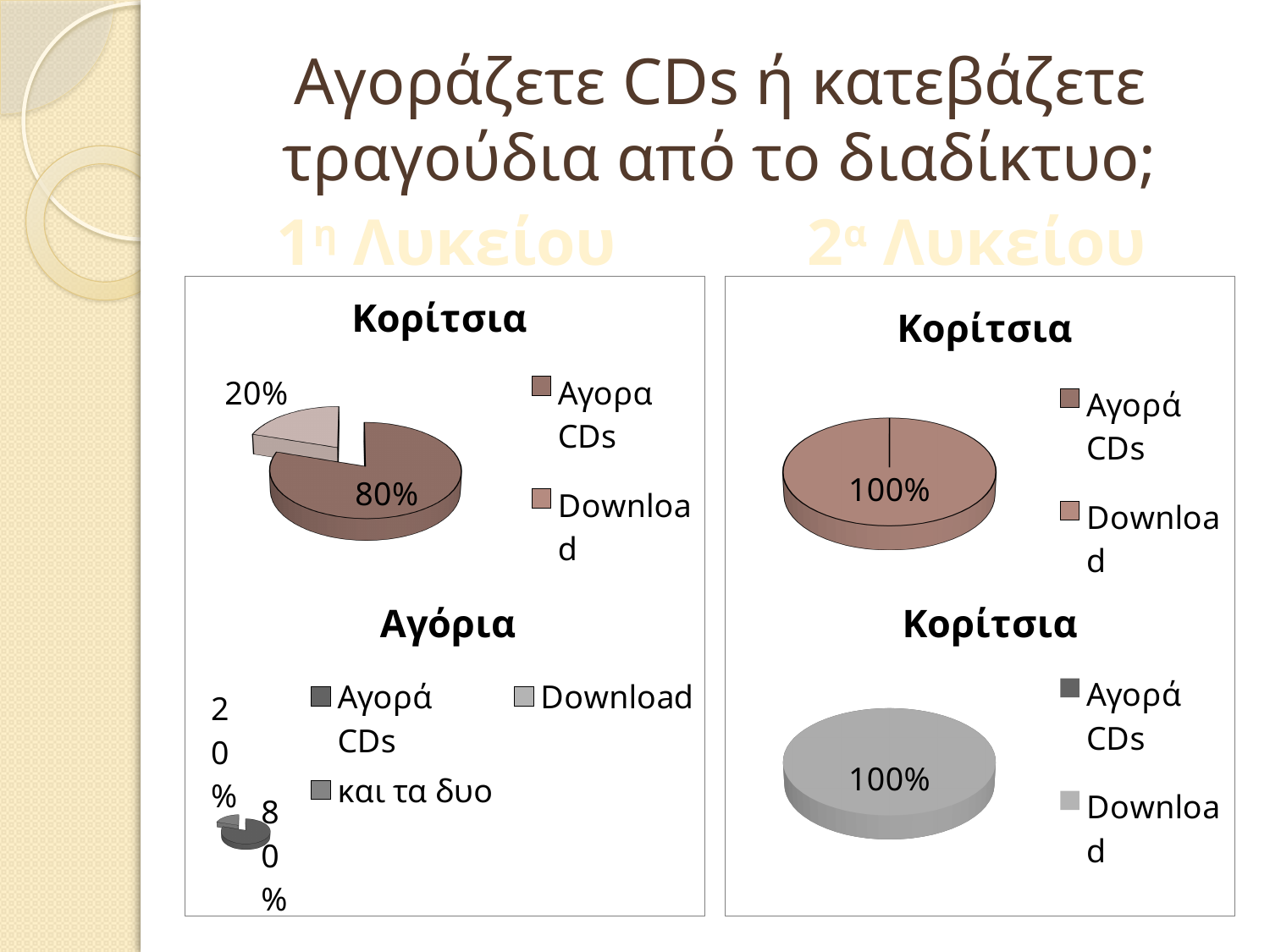
In the top-left pie chart titled Κορίτσια (1η Λυκείου), is the slice for Αγορα CDs larger or smaller than the slice for Download? larger In the top-right pie chart titled Κορίτσια (2α Λυκείου), what percentage is printed on the pie? 100% How many entries does the legend of the top-left pie chart titled Κορίτσια (1η Λυκείου) list? 2 What type of chart is the top-right chart titled Κορίτσια (2α Λυκείου)? pie chart In the top-left pie chart titled Κορίτσια (1η Λυκείου), what percentage is shown for Αγορα CDs? 80% In the bottom-right pie chart titled Κορίτσια (2α Λυκείου), what percentage is printed on the pie? 100% In the top-left pie chart titled Κορίτσια (1η Λυκείου), which category has the largest slice? Αγορα CDs How many entries does the legend of the bottom-left pie chart titled Αγόρια list? 3 How many pie charts are shown on the slide in total? 4